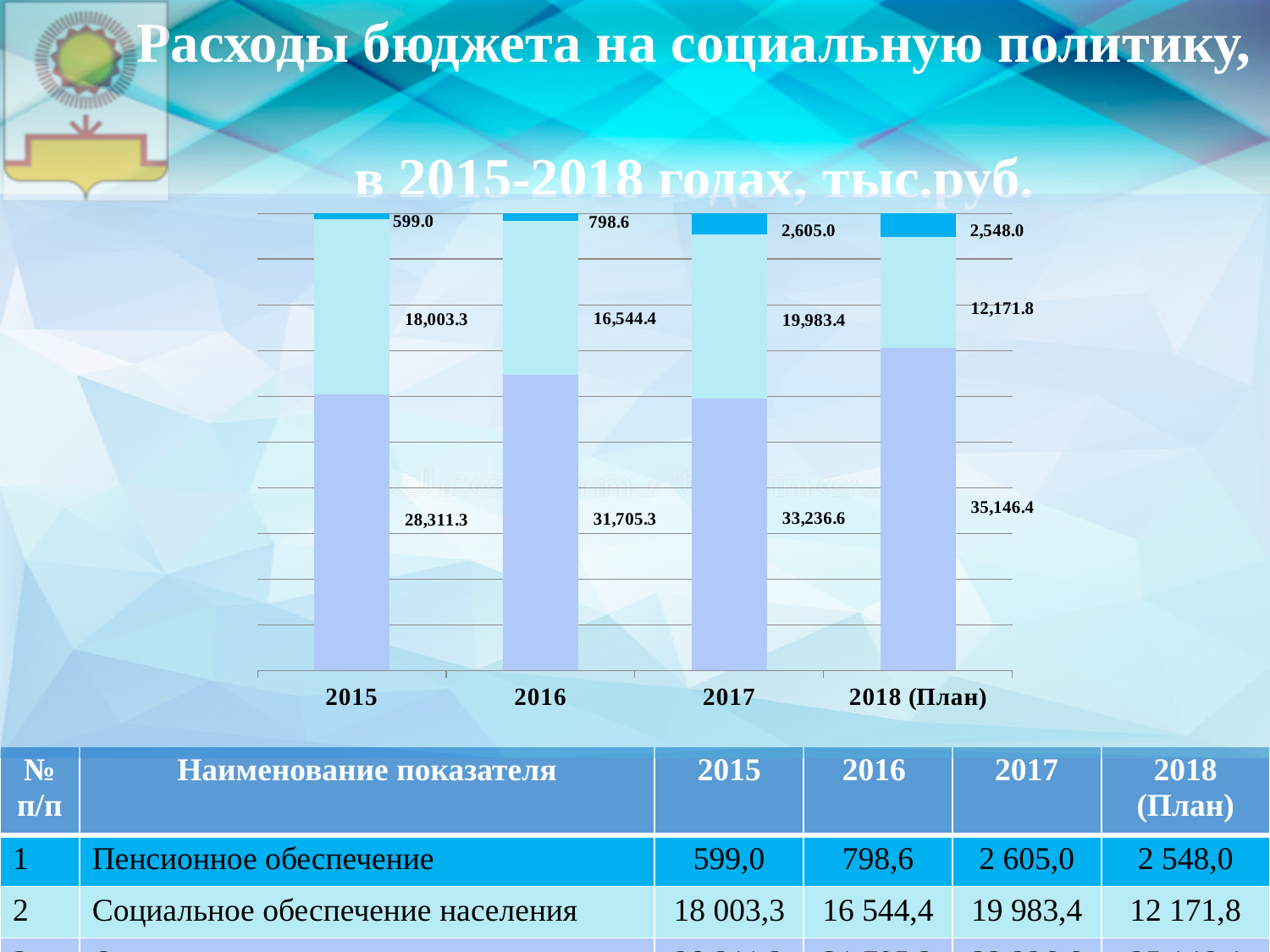
What is the value of the middle (light blue) segment of the bar for 2016? 16,544.4 Does the bottom (lavender) segment rise or fall from 2015 to 2018 (План)? rise What is the difference between the bottom segment values for 2016 and 2015? 3,394.0 Which is larger: the middle segment for 2017 or the middle segment for 2015? 2017 What is the total of the stacked bar for 2017? 55,825.0 What is the total of the stacked bar for 2015? 46,913.6 In which year is the middle (light blue) segment the smallest? 2018 (План) In which year is the top (dark blue) segment the largest? 2017 What is the value of the top (dark blue) segment of the bar for 2017? 2,605.0 How many years (categories) are shown on the x axis of the chart? 4 What is the value of the bottom (lavender) segment of the bar for 2018 (План)? 35,146.4 What type of chart is shown on the slide? stacked bar chart